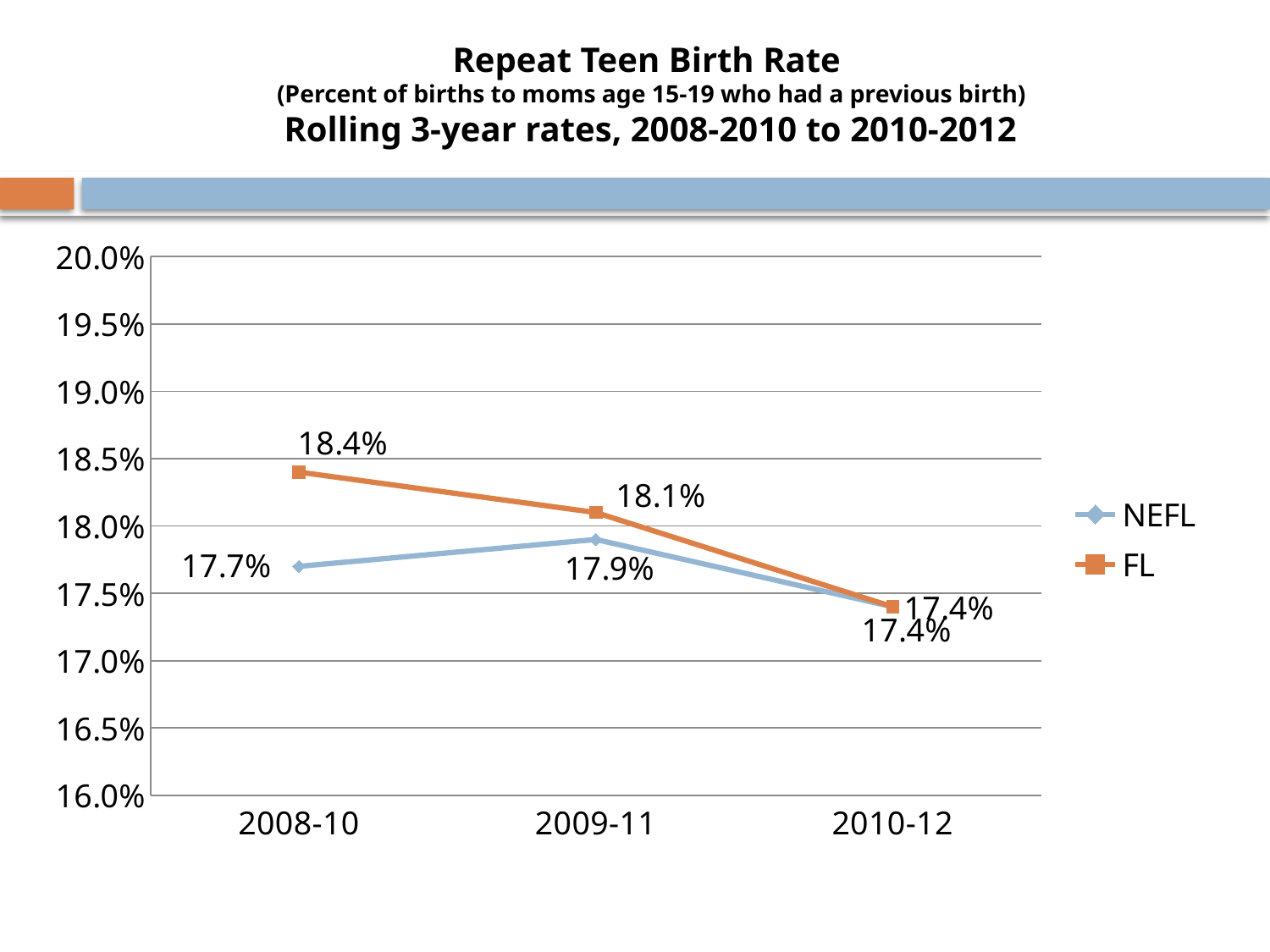
Does the FL rate rise or fall from 2008-10 to 2010-12? Fall In which period is the NEFL rate lowest? 2010-12 Which is larger in 2009-11, the FL rate or the NEFL rate? FL What is the difference between the FL and NEFL rates in 2008-10? 0.7% What is the FL repeat teen birth rate for 2009-11? 18.1% How many series does the legend list? 2 How many periods are shown on the x axis? 3 What kind of chart is shown on the slide? Line chart What is the NEFL repeat teen birth rate for 2008-10? 17.7% In which period is the FL rate highest? 2008-10 What is the FL value for 2008-10? 18.4% What is the NEFL value for 2010-12? 17.4%